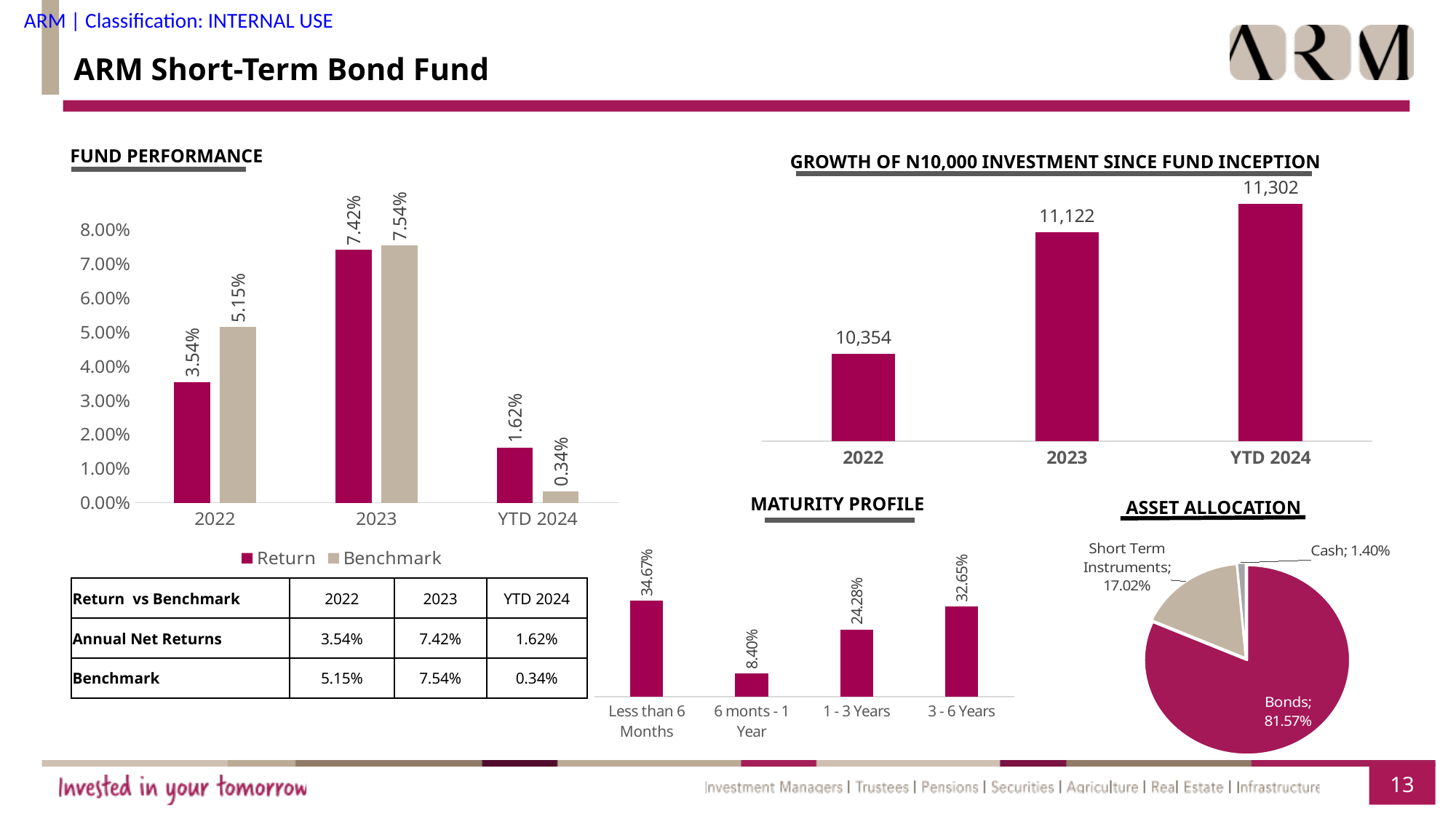
How many categories are shown in the Maturity Profile chart? 4 In the Fund Performance chart, what is the Benchmark value for YTD 2024? 0.34% In the Fund Performance chart, which is larger for YTD 2024, Return or Benchmark? Return In the Maturity Profile chart, which category has the highest value? Less than 6 Months In the Growth of N10,000 Investment Since Fund Inception chart, what is the value for 2023? 11,122 In the Fund Performance chart, what is the difference between the Benchmark and the Return for 2022? 1.61% In the Fund Performance chart, what is the Return value for 2023? 7.42% In the Growth of N10,000 Investment Since Fund Inception chart, which year has the lowest value? 2022 In the Growth of N10,000 Investment Since Fund Inception chart, do the values rise or fall from 2022 to YTD 2024? rise How many series does the legend of the Fund Performance chart list? 2 In the Maturity Profile chart, what is the value for 1 - 3 Years? 24.28% In the Asset Allocation chart, what share of the pie is Short Term Instruments? 17.02%